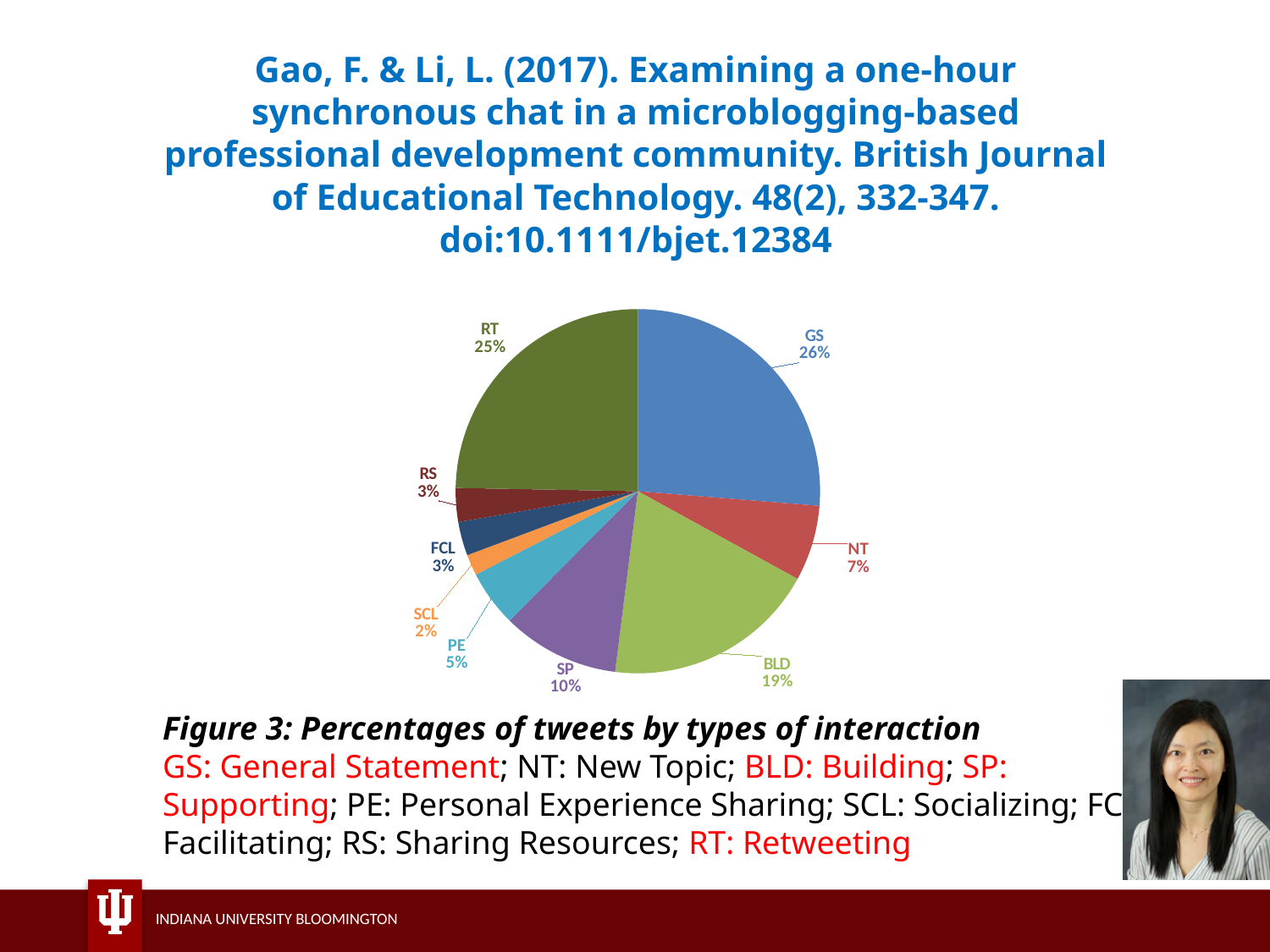
Which type of interaction has the largest share of tweets? GS What percentage of tweets are General Statements (GS)? 26% How many types of interaction are shown in the pie chart? 9 What is the combined percentage of FCL and RS? 6% Which has a larger share of tweets, NT or PE? NT What percentage of tweets are Building (BLD)? 19% What percentage of tweets are Retweeting (RT)? 25% What percentage of tweets are Socializing (SCL)? 2% Which type of interaction has the smallest share of tweets? SCL What is the title of the figure shown on the slide? Figure 3: Percentages of tweets by types of interaction What kind of chart is shown on the slide? Pie chart What is the difference in percentage points between BLD and SP? 9